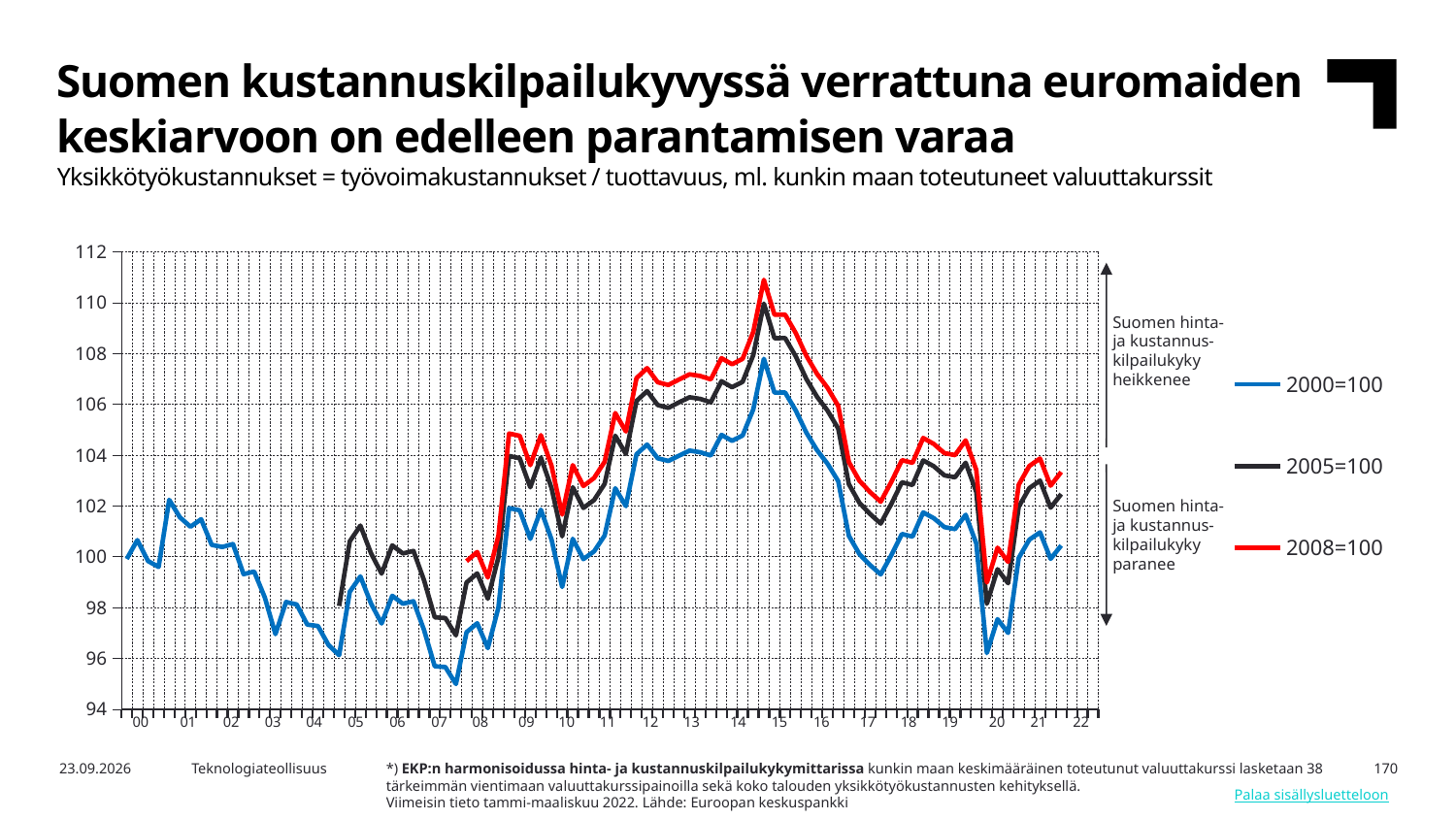
What kind of chart is shown on the slide? line chart Around 2020, which series is higher: 2008=100 or 2000=100? 2008=100 Is the value of the 2000=100 series at its dip in 2020 greater or less than 98? less Does the 2000=100 series rise or fall between its peak around 2014–15 and 2017? fall Which series reaches the highest value on the chart? 2008=100 What is the highest value shown on the vertical axis? 112 How many series does the chart legend list? 3 How many year labels are shown on the horizontal axis? 23 Is the lowest value of the 2000=100 series around 2007 greater or less than 97? less Is the peak value of the 2008=100 series around 2014–15 greater or less than 108? greater Which series reaches the lowest value on the chart? 2000=100 Which series is drawn in red? 2008=100